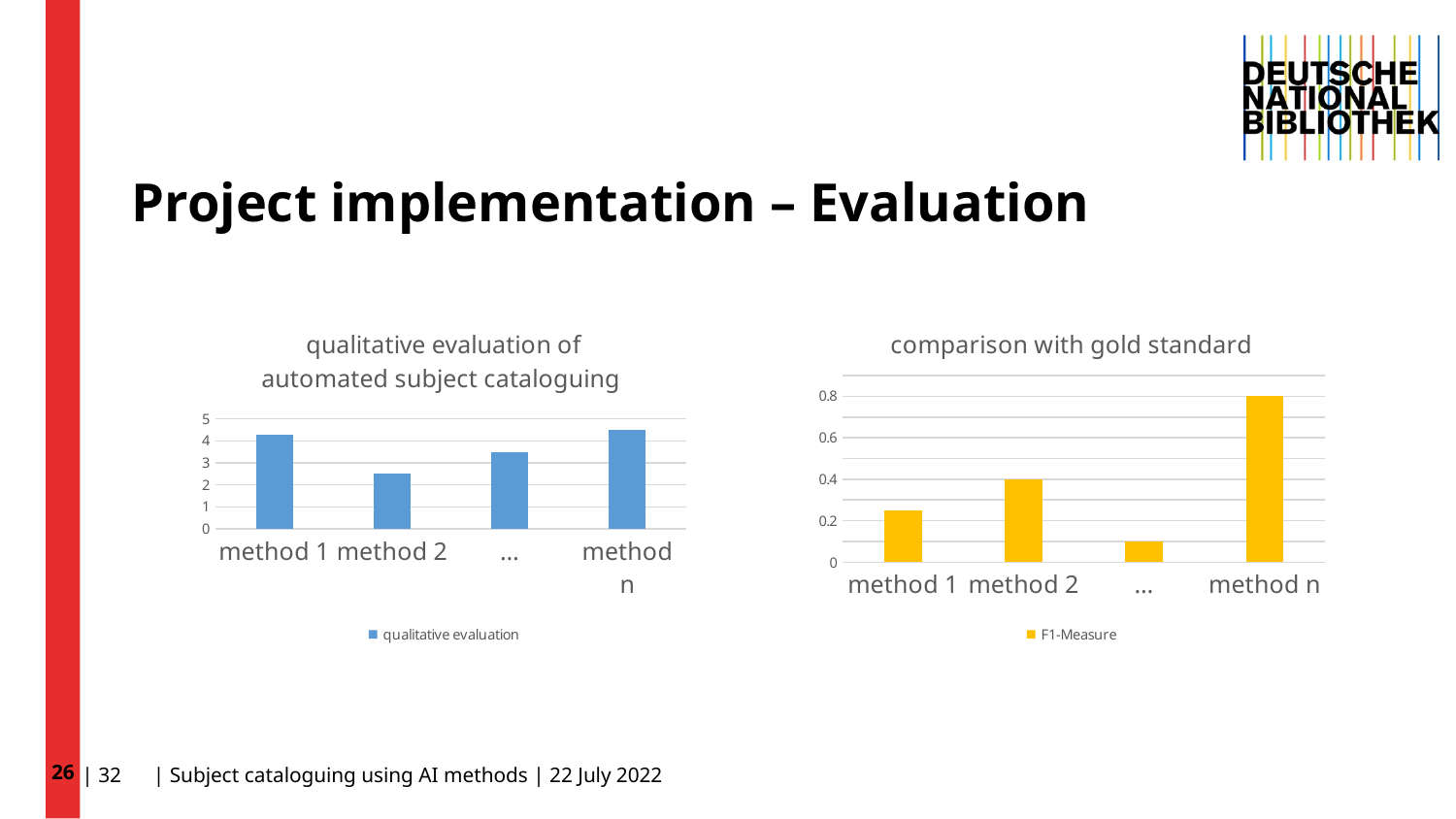
How many categories are shown on the x axis of the chart titled "comparison with gold standard"? 4 What kind of chart is the chart on the left of the slide? bar chart In the chart titled "qualitative evaluation of automated subject cataloguing", which category has the lowest value? method 2 In the chart titled "qualitative evaluation of automated subject cataloguing", is the value for method 1 greater or less than 4? greater In the chart titled "comparison with gold standard", which category has the highest F1-Measure? method n In the chart titled "comparison with gold standard", what is the F1-Measure for method n? 0.8 In the chart titled "comparison with gold standard", is the value for method 1 greater or less than 0.4? less In the chart titled "comparison with gold standard", which category has the lowest F1-Measure? ... In the chart titled "qualitative evaluation of automated subject cataloguing", which is larger, the value for method 2 or the value for "..."? ... In the chart titled "comparison with gold standard", what is the F1-Measure for method 2? 0.4 What series name does the legend of the chart titled "comparison with gold standard" show? F1-Measure In the chart titled "qualitative evaluation of automated subject cataloguing", which category has the highest value? method n